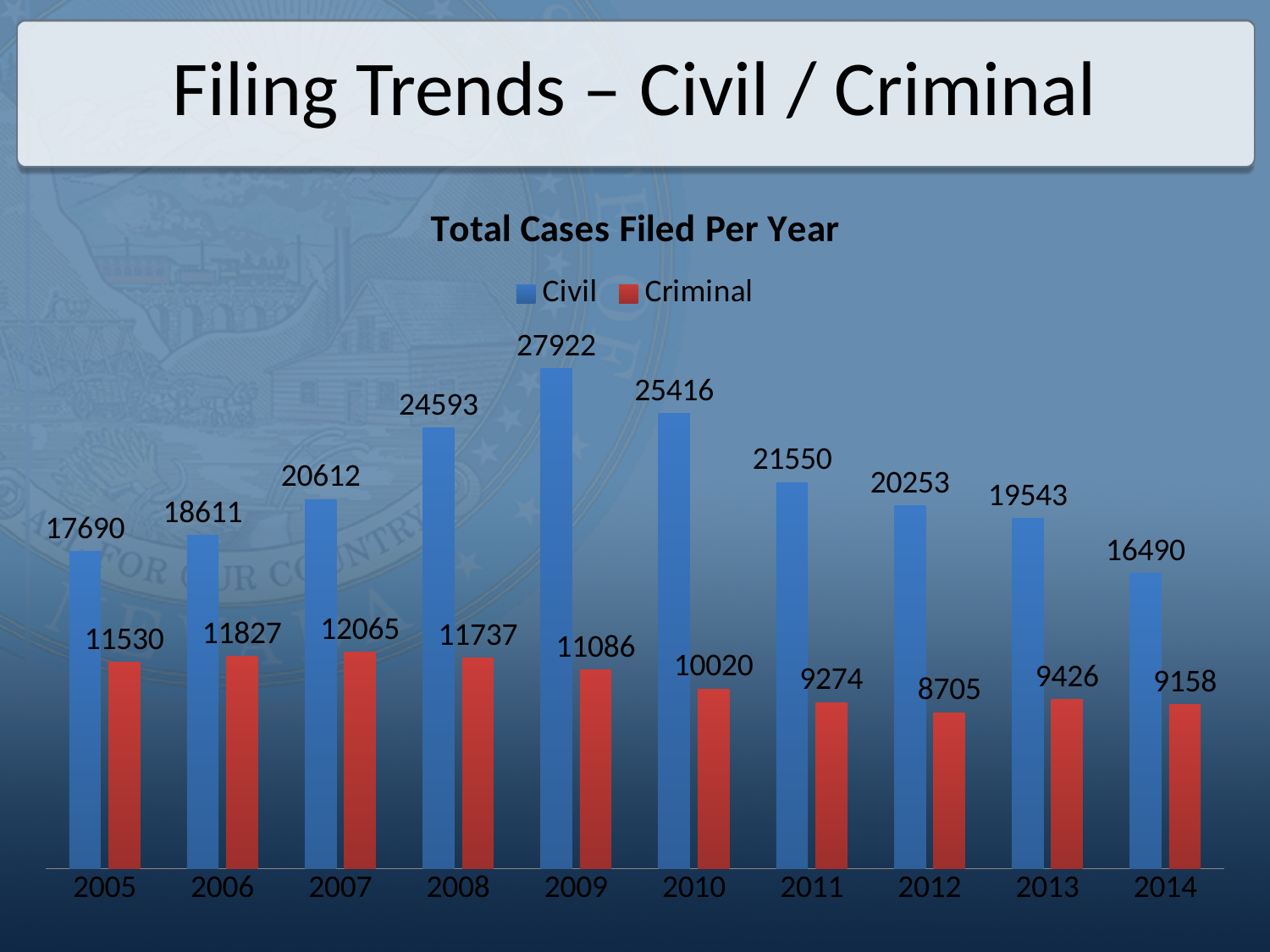
What is the Civil value for 2009? 27922 What is the Criminal value for 2012? 8705 Do the Civil values rise or fall from 2009 to 2014? fall Which year has the lowest Criminal value? 2012 What is the title of the chart? Total Cases Filed Per Year Which year has the highest Civil value? 2009 Which year has the lowest Civil value? 2014 Which is larger, the Criminal value for 2007 or the Criminal value for 2008? 2007 How many series does the legend list? 2 What kind of chart is shown? bar chart How many years are shown on the x axis? 10 What is the difference between the Civil and Criminal values for 2009? 16836